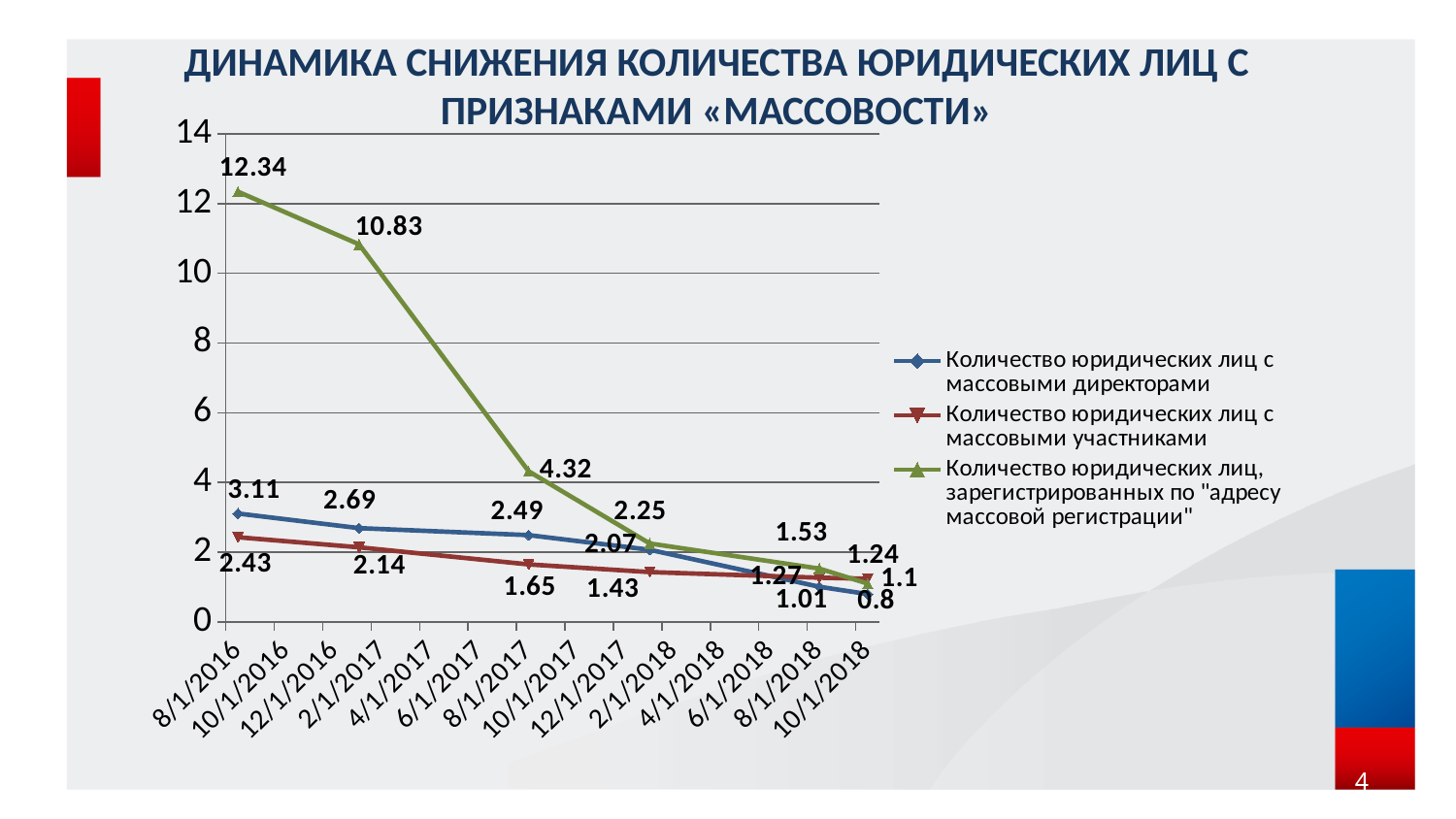
What is the first plotted value (at 8/1/2016) for the series 'Количество юридических лиц, зарегистрированных по "адресу массовой регистрации"'? 12.34 What is the highest value plotted for the series 'Количество юридических лиц, зарегистрированных по "адресу массовой регистрации"'? 12.34 How many series does the legend list? 3 What is the difference between the first values of 'Количество юридических лиц с массовыми директорами' (3.11) and 'Количество юридических лиц с массовыми участниками' (2.43)? 0.68 What is the difference between the first two plotted values (12.34 and 10.83) of the series 'Количество юридических лиц, зарегистрированных по "адресу массовой регистрации"'? 1.51 Is the value 4.32 for the series 'Количество юридических лиц, зарегистрированных по "адресу массовой регистрации"' greater or less than 4? greater What is the first plotted value (at 8/1/2016) for the series 'Количество юридических лиц с массовыми участниками'? 2.43 What is the last plotted value (at 10/1/2018) for the series 'Количество юридических лиц с массовыми директорами'? 0.8 At 8/1/2016, which series has the larger value: 'Количество юридических лиц с массовыми директорами' or 'Количество юридических лиц с массовыми участниками'? Количество юридических лиц с массовыми директорами Do the values of the series 'Количество юридических лиц, зарегистрированных по "адресу массовой регистрации"' rise or fall along the x axis? fall What type of chart is shown on the slide? line chart What is the first plotted value (at 8/1/2016) for the series 'Количество юридических лиц с массовыми директорами'? 3.11